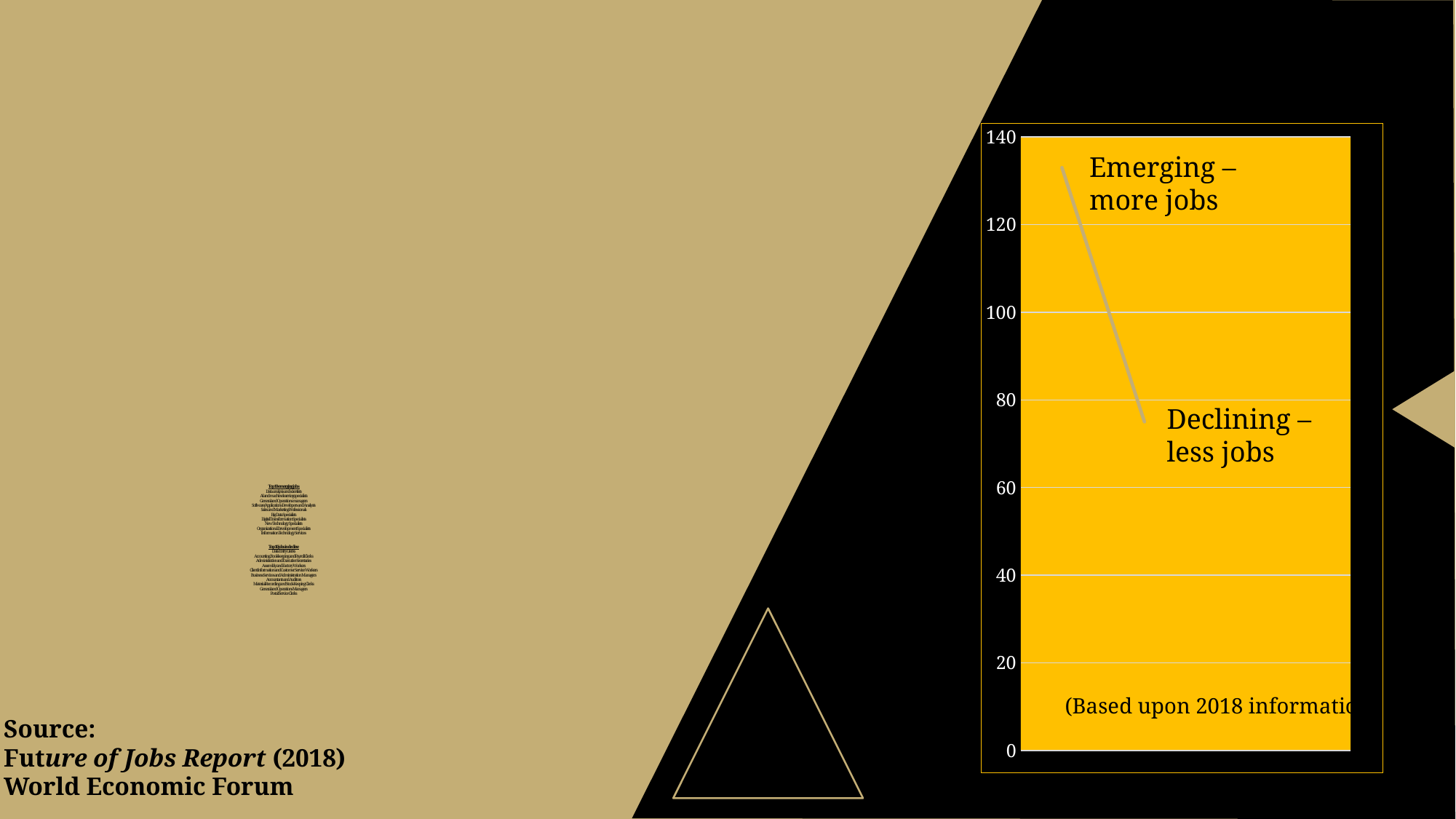
What kind of chart is shown on the right side of the slide? line chart What is the highest value shown on the chart's vertical axis? 140 Is the value at the 'Declining – less jobs' end of the line greater or less than 60? greater Does the line in the chart rise or fall from left to right? fall Which is larger, the value at the 'Emerging – more jobs' end or the 'Declining – less jobs' end of the line? Emerging – more jobs What year does the note inside the chart say the information is based upon? 2018 Is the value at the 'Declining – less jobs' end of the line greater or less than 80? less Is the value at the 'Emerging – more jobs' end of the line greater or less than 120? greater How many data points does the line in the chart have? 2